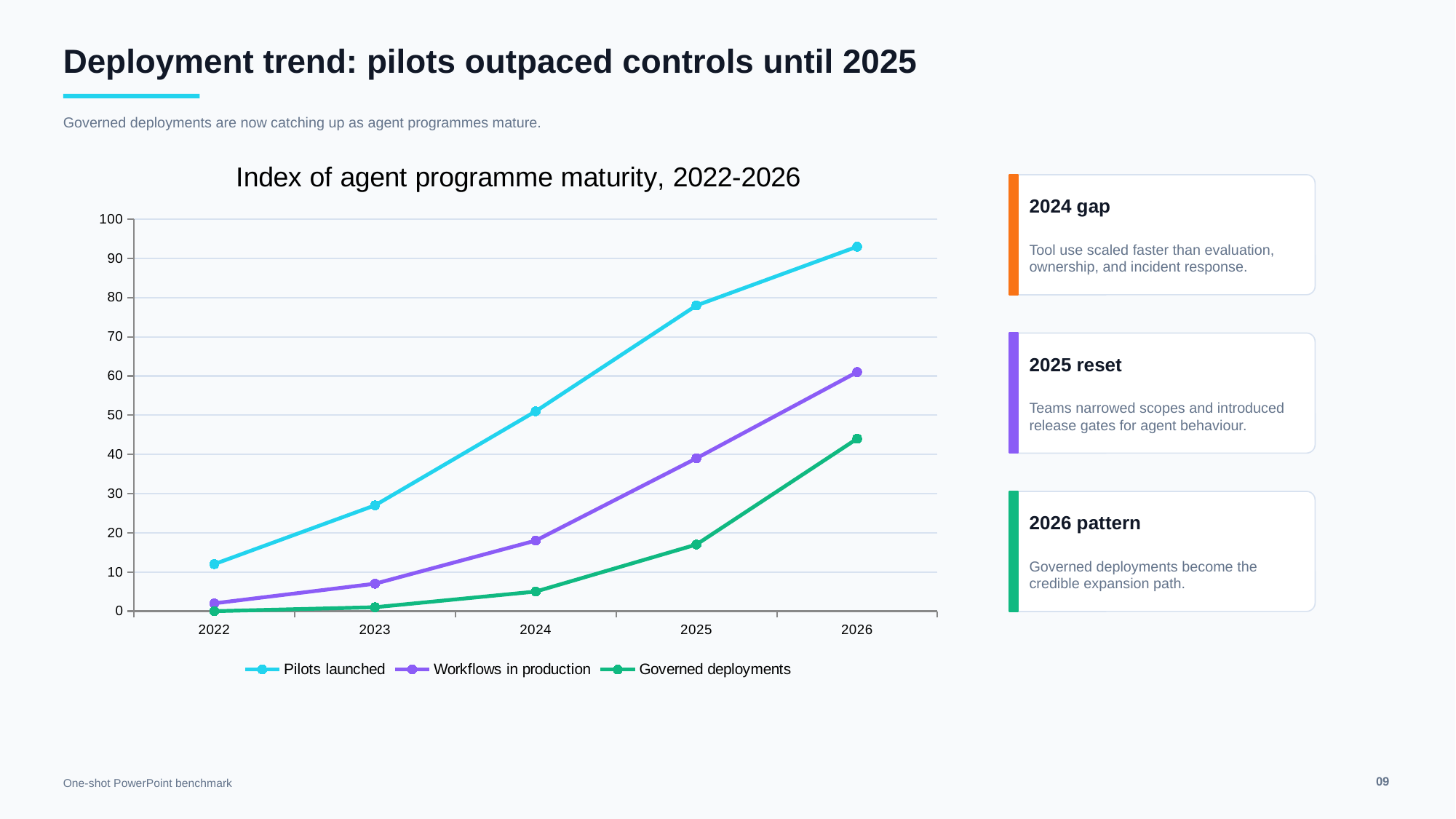
What kind of chart is shown on the slide? line chart In 2025, which is larger: Workflows in production or Governed deployments? Workflows in production Which series is shown in purple in the legend? Workflows in production Do the values for Pilots launched rise or fall from 2022 to 2026? rise How many series does the legend list? 3 Which series has the lowest value in 2026? Governed deployments Is the value for Governed deployments in 2024 greater or less than 10? less Is the value for Pilots launched in 2026 greater or less than 90? greater What is the title of the chart? Index of agent programme maturity, 2022-2026 Which series has the highest value in 2024? Pilots launched How many years are plotted along the x axis? 5